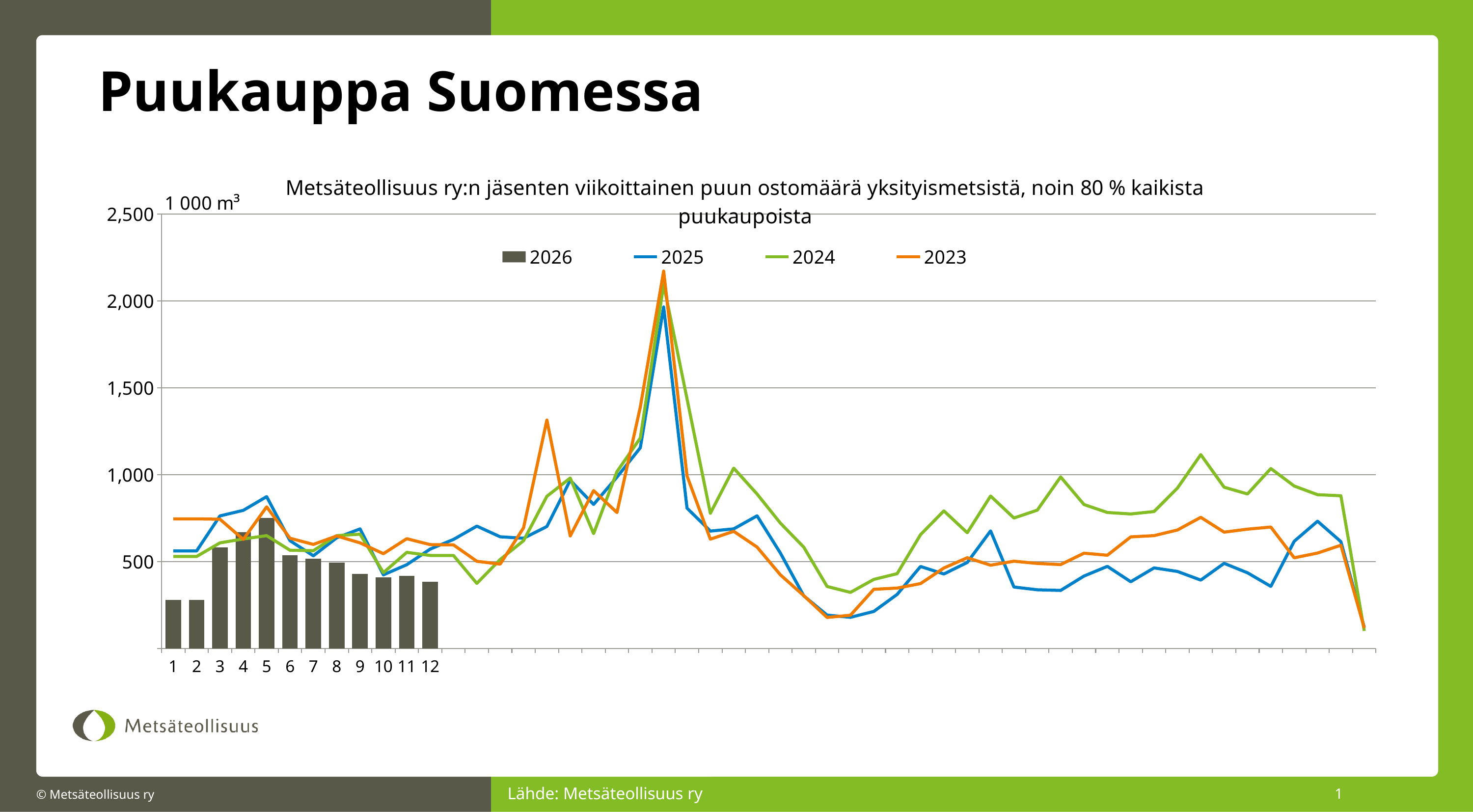
Is the peak value of the 2023 line greater or less than 2,000? greater Which is larger, the 2026 bar for week 5 or the 2026 bar for week 12? Week 5 Is the 2026 bar for week 5 greater or less than 500? greater Which series reaches the highest peak on the chart? 2023 How many series does the legend list? 4 Do the 2026 bars rise or fall from week 5 to week 12? Fall Which week has the highest 2026 bar? Week 5 Is the 2026 bar for week 12 greater or less than 500? less How many bars are plotted for the 2026 series? 12 What kind of chart is shown on the slide? A combined bar and line chart